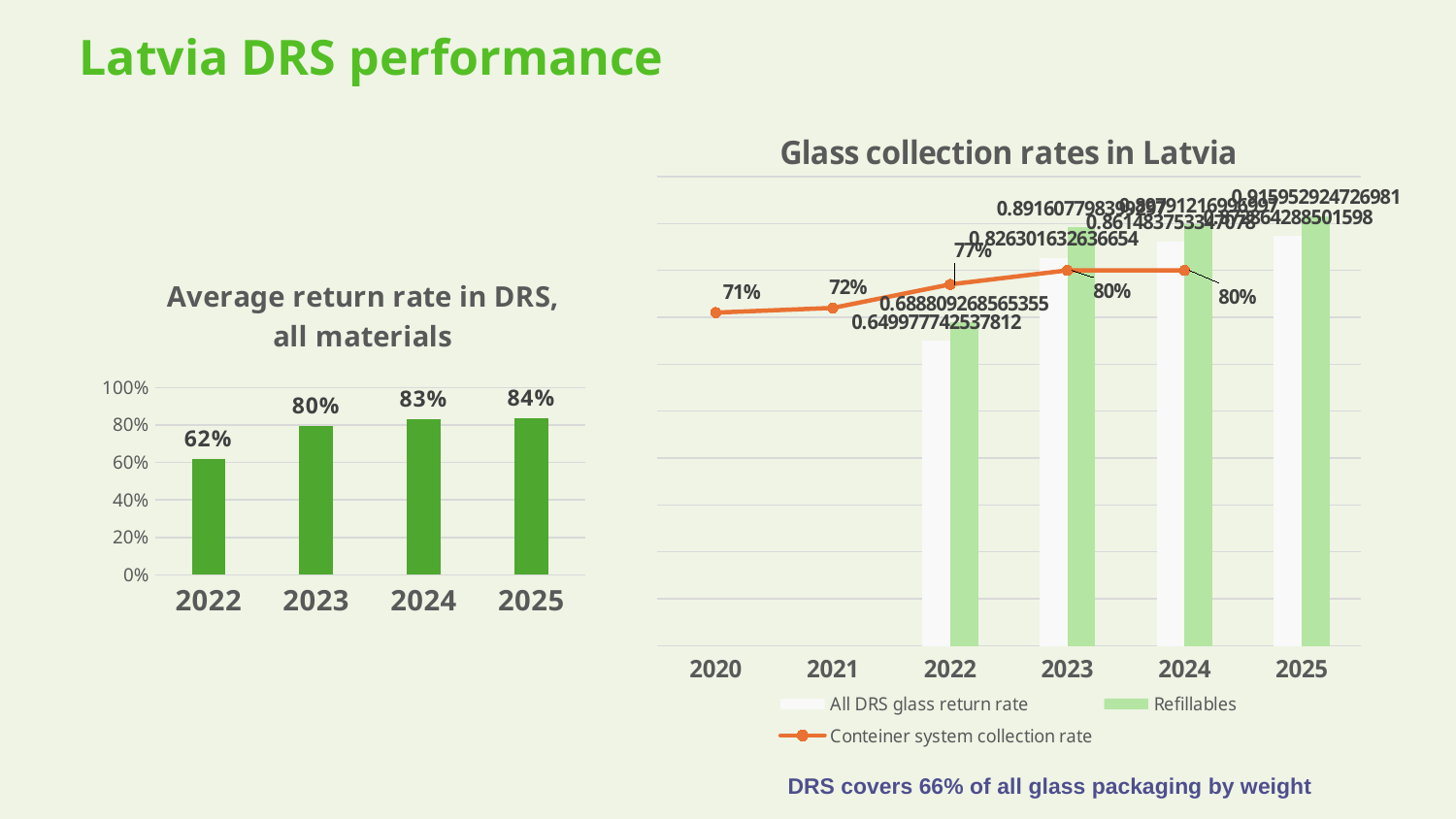
What type of chart is 'Average return rate in DRS, all materials'? Bar chart In the 'Glass collection rates in Latvia' chart, what is the container system collection rate for 2022? 77% In the 'Average return rate in DRS, all materials' chart, what is the value for 2022? 62% How many years are shown in the 'Average return rate in DRS, all materials' chart? 4 In the 'Average return rate in DRS, all materials' chart, what is the value for 2025? 84% In the 'Average return rate in DRS, all materials' chart, which year has the highest return rate? 2025 In the 'Glass collection rates in Latvia' chart, what is the container system collection rate for 2020? 71% How many series does the legend of the 'Glass collection rates in Latvia' chart list? 3 In the 'Average return rate in DRS, all materials' chart, do the values rise or fall from 2022 to 2025? Rise How many years are shown on the x axis of the 'Glass collection rates in Latvia' chart? 6 In the 'Average return rate in DRS, all materials' chart, which year has the lowest return rate? 2022 In the 'Average return rate in DRS, all materials' chart, by how many percentage points did the return rate increase from 2022 to 2023? 18 percentage points